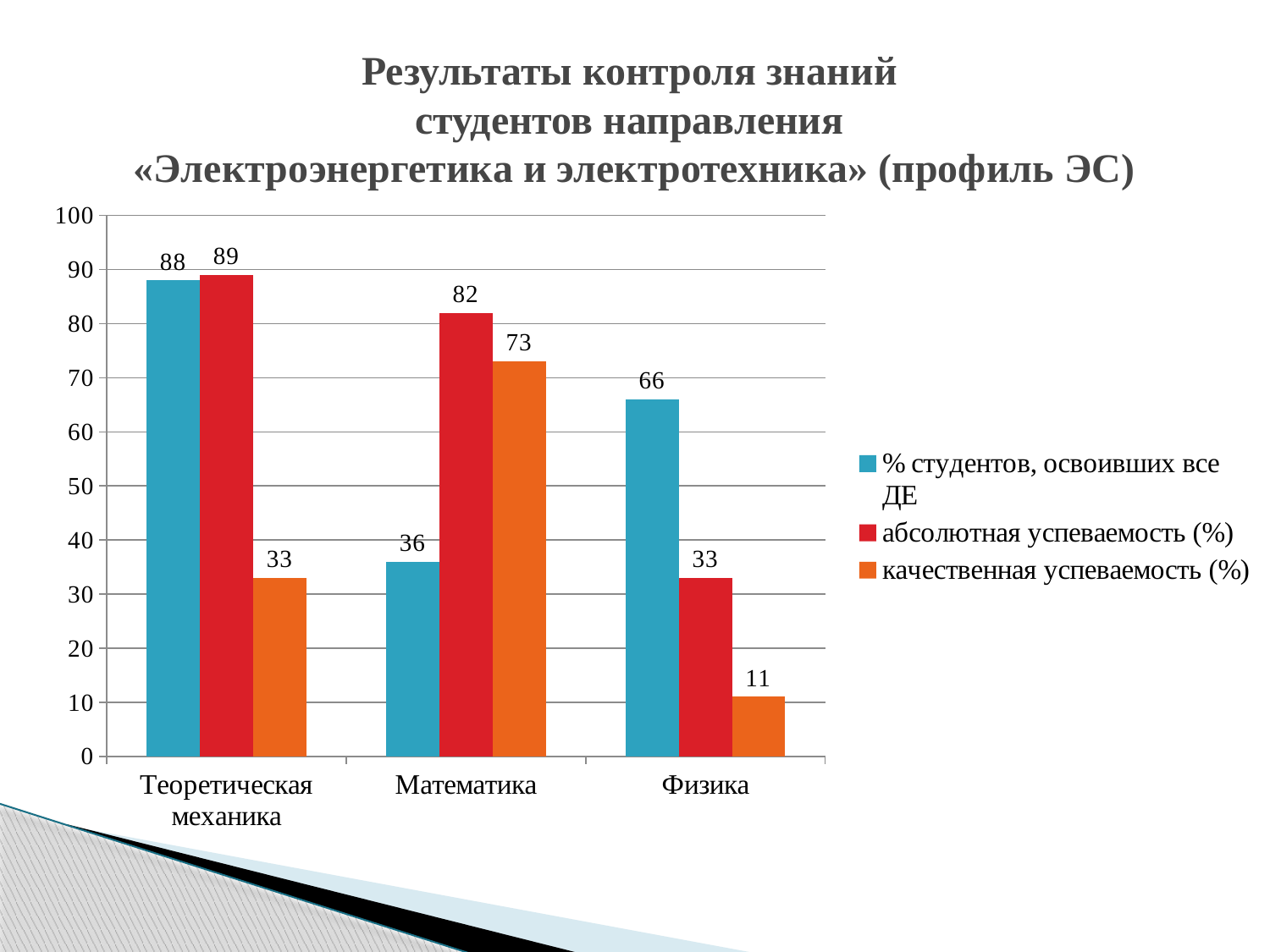
What kind of chart is shown on the slide? bar chart What is the value of «абсолютная успеваемость (%)» for Математика? 82 Which is larger: «% студентов, освоивших все ДЕ» for Физика or «качественная успеваемость (%)» for Математика? качественная успеваемость (%) for Математика What is the value of «% студентов, освоивших все ДЕ» for Теоретическая механика? 88 Which colour represents «абсолютная успеваемость (%)» in the legend? red What is the difference between «абсолютная успеваемость (%)» for Теоретическая механика and for Физика? 56 Which subject has the lowest value for «% студентов, освоивших все ДЕ»? Математика Does the value of «абсолютная успеваемость (%)» rise or fall from Теоретическая механика to Физика? fall How many series does the legend list? 3 Which subject has the highest value for «качественная успеваемость (%)»? Математика How many subjects are shown on the x axis? 3 What is the value of «качественная успеваемость (%)» for Физика? 11